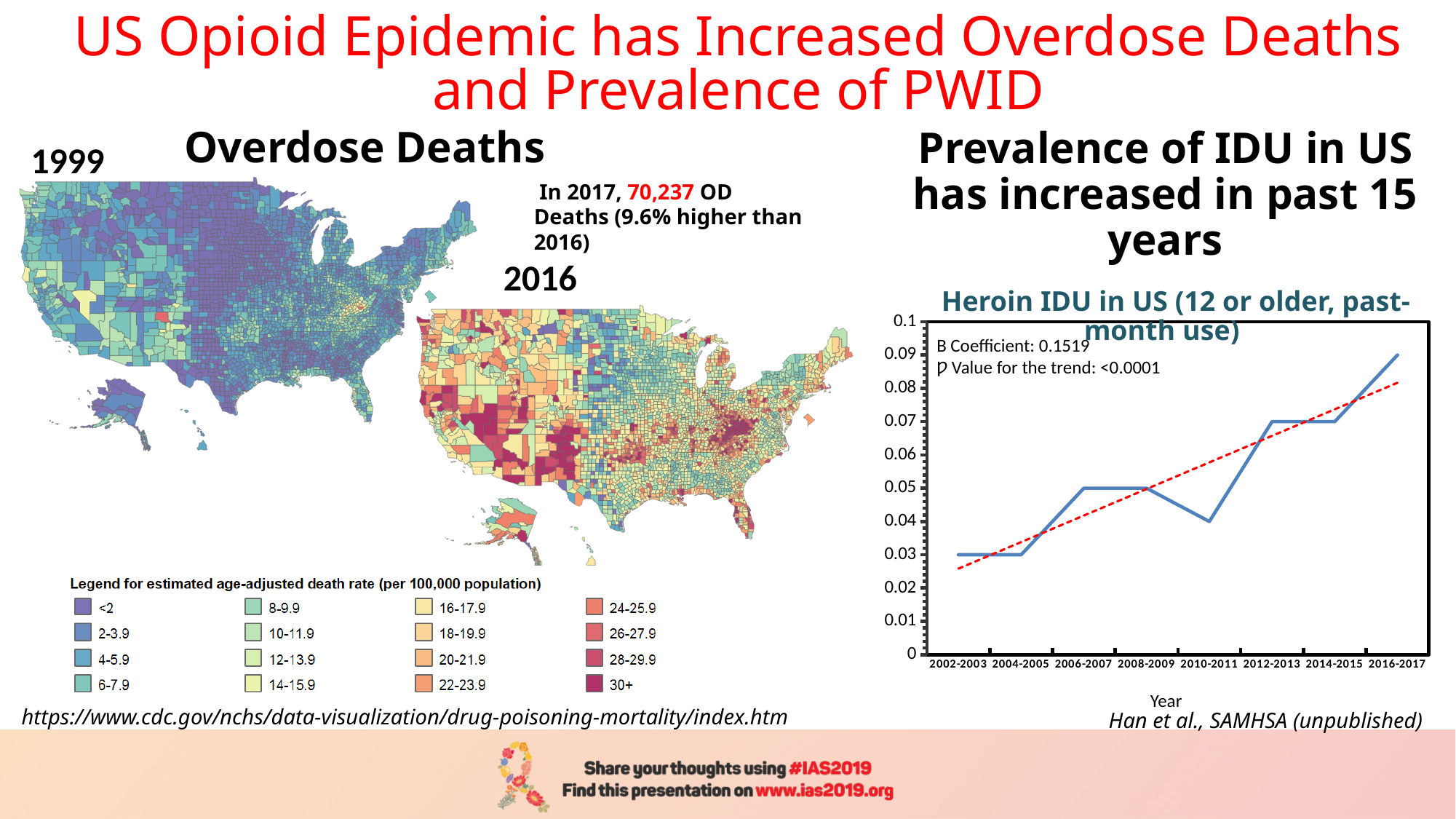
In the 'Heroin IDU in US' line chart, how many year-pair points are plotted along the x axis? 8 What kind of chart is the 'Heroin IDU in US (12 or older, past-month use)' chart? line chart What is the x-axis label of the 'Heroin IDU in US' line chart? Year In the 'Heroin IDU in US' line chart, do the values generally rise or fall from 2002-2003 to 2016-2017? rise In the 'Heroin IDU in US' line chart, what is the value for 2010-2011? 0.04 In the 'Heroin IDU in US' line chart, which is larger, the value for 2008-2009 or the value for 2012-2013? 2012-2013 In the 'Heroin IDU in US' line chart, what is the value for 2012-2013? 0.07 In the 'Heroin IDU in US' line chart, what is the difference between the value for 2012-2013 and the value for 2008-2009? 0.02 In the 'Heroin IDU in US' line chart, what is the value for 2002-2003? 0.03 What B Coefficient is printed on the 'Heroin IDU in US' line chart? 0.1519 In the 'Heroin IDU in US' line chart, is the value for 2010-2011 greater or less than 0.05? less In the 'Heroin IDU in US' line chart, which year pair has the highest value? 2016-2017